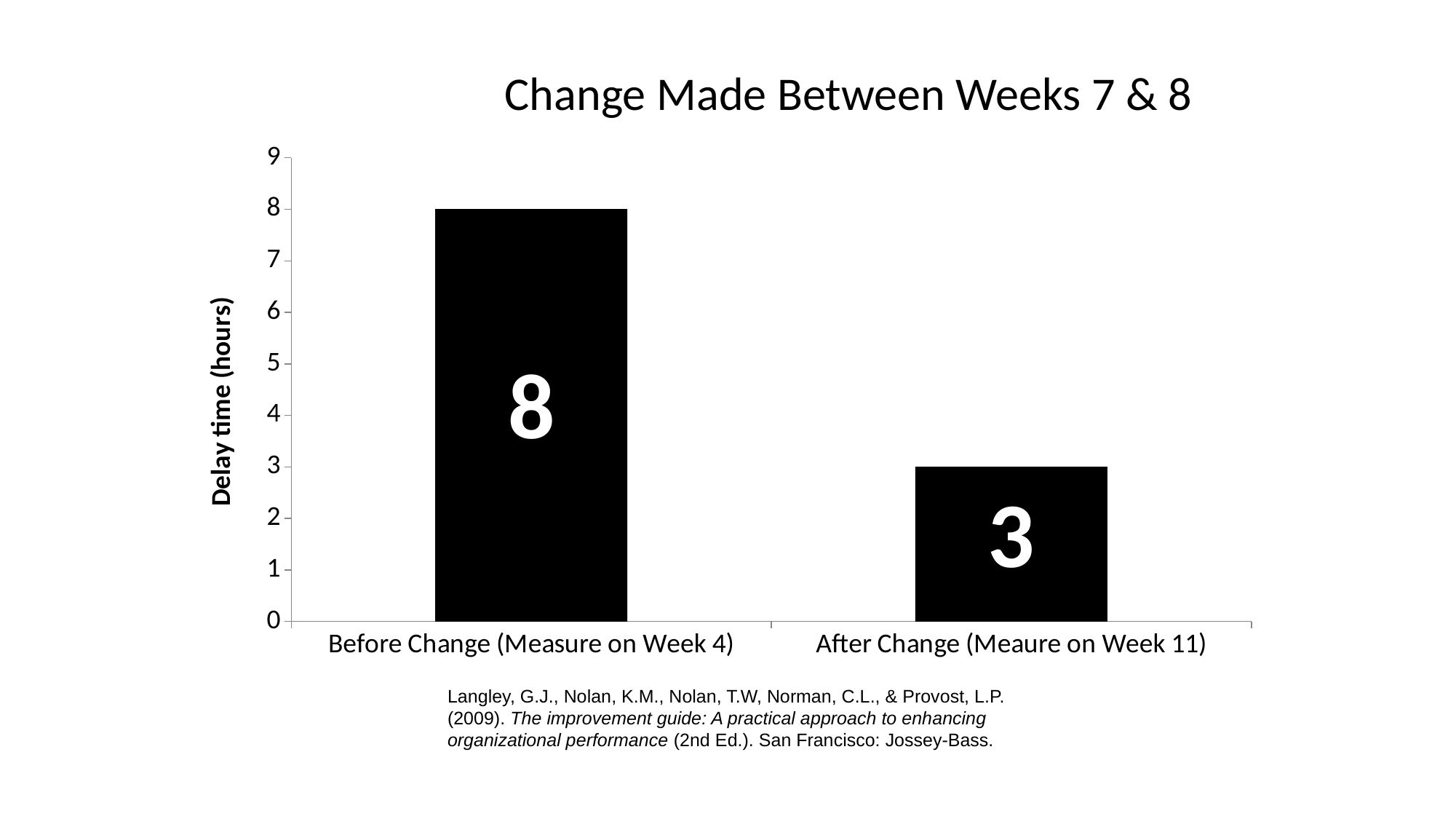
Which is larger, the delay time Before Change or After Change? Before Change (Measure on Week 4) What is the delay time for Before Change (Measure on Week 4)? 8 Which category has the highest delay time? Before Change (Measure on Week 4) Do the values rise or fall from Before Change to After Change? fall What kind of chart is shown on the slide? bar chart What is the delay time for After Change (Meaure on Week 11)? 3 What is the title of the chart? Change Made Between Weeks 7 & 8 How many categories are shown in the chart? 2 What is the difference in delay time between Before Change and After Change? 5 Is the delay time for After Change greater or less than 5? less Which category has the lowest delay time? After Change (Meaure on Week 11) What is the label of the vertical axis? Delay time (hours)